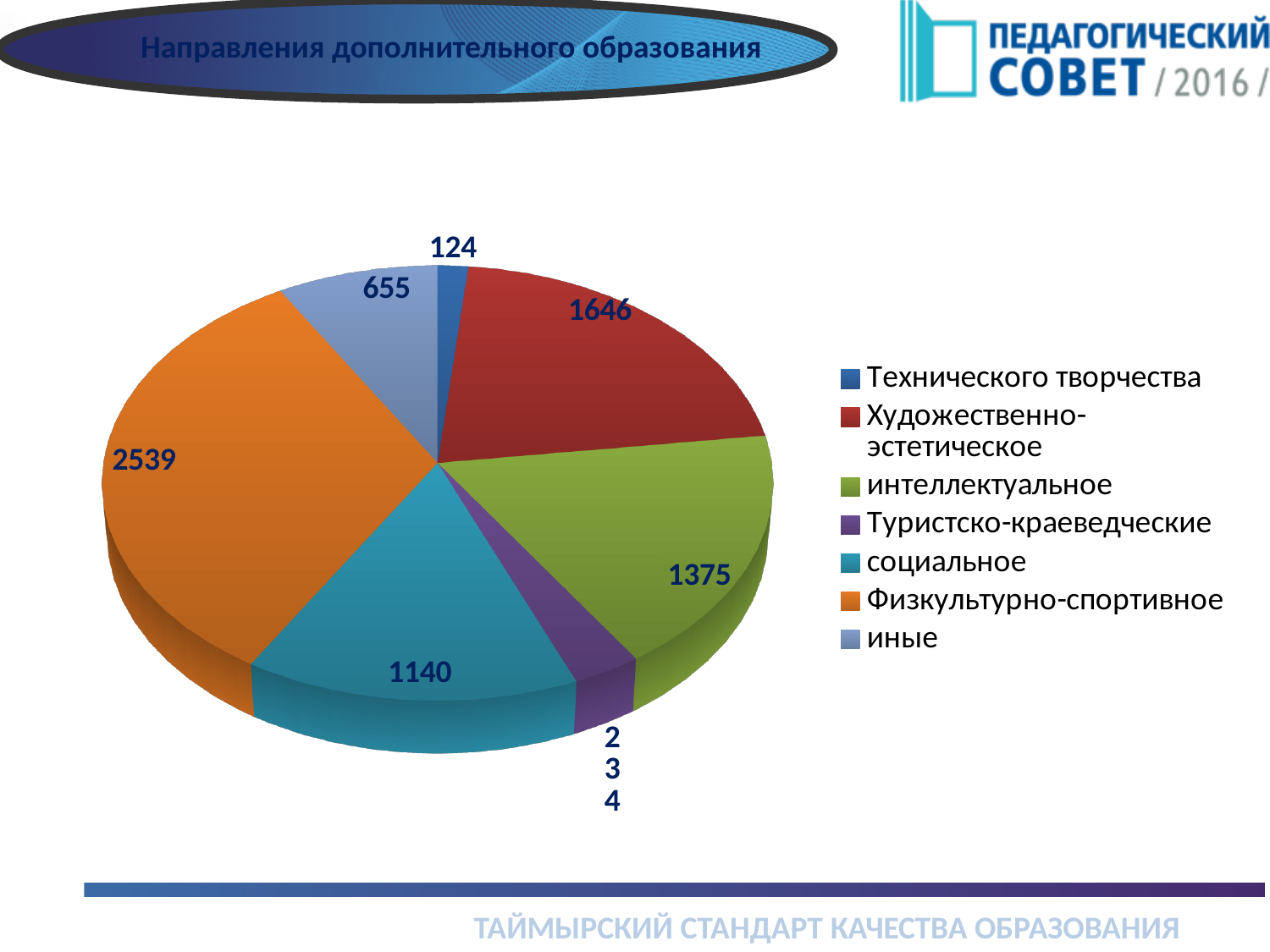
What is the difference between the values for Физкультурно-спортивное and Художественно-эстетическое? 893 What kind of chart is shown on the slide? Pie chart Which category has the smallest slice of the pie? Технического творчества What is the total of all the values shown in the pie chart? 7713 Which category has the largest slice of the pie? Физкультурно-спортивное How many categories does the pie chart have? 7 What is the value for иные? 655 What is the title of the chart shown on the slide? Направления дополнительного образования What is the value for Физкультурно-спортивное? 2539 What is the value for Художественно-эстетическое? 1646 What is the value for социальное? 1140 Which is larger, интеллектуальное or социальное? интеллектуальное